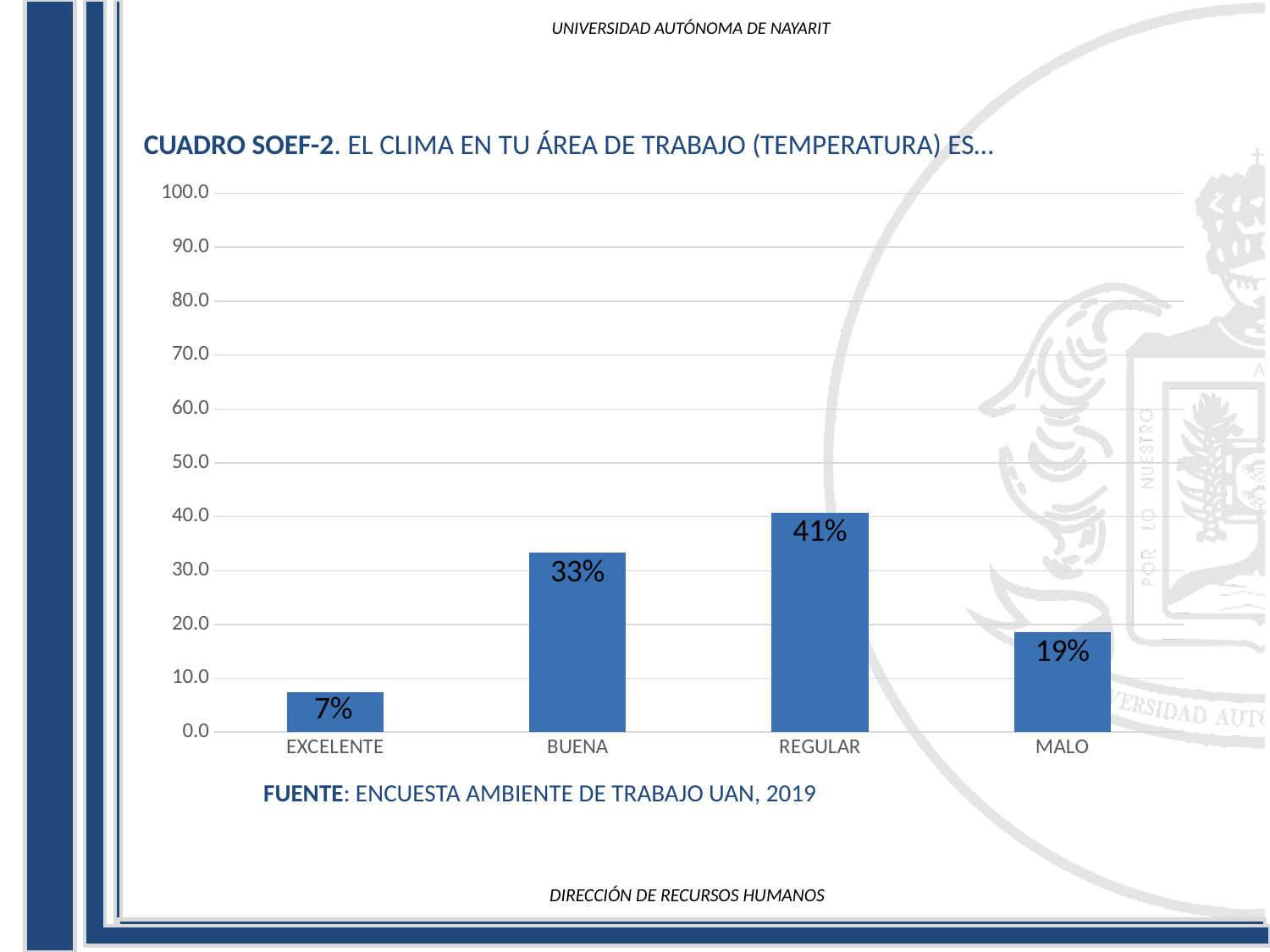
What is the value for REGULAR? 41% Which is larger, the value for BUENA or the value for MALO? BUENA What is the difference between the values for MALO and EXCELENTE? 12% Is the value for REGULAR greater or less than 50.0? less What is the value for EXCELENTE? 7% What is the value for BUENA? 33% What is the value for MALO? 19% How many categories are shown on the x axis? 4 Which category has the lowest value? EXCELENTE What kind of chart is shown on the slide? bar chart Which category has the highest value? REGULAR What is the difference between the values for REGULAR and BUENA? 8%